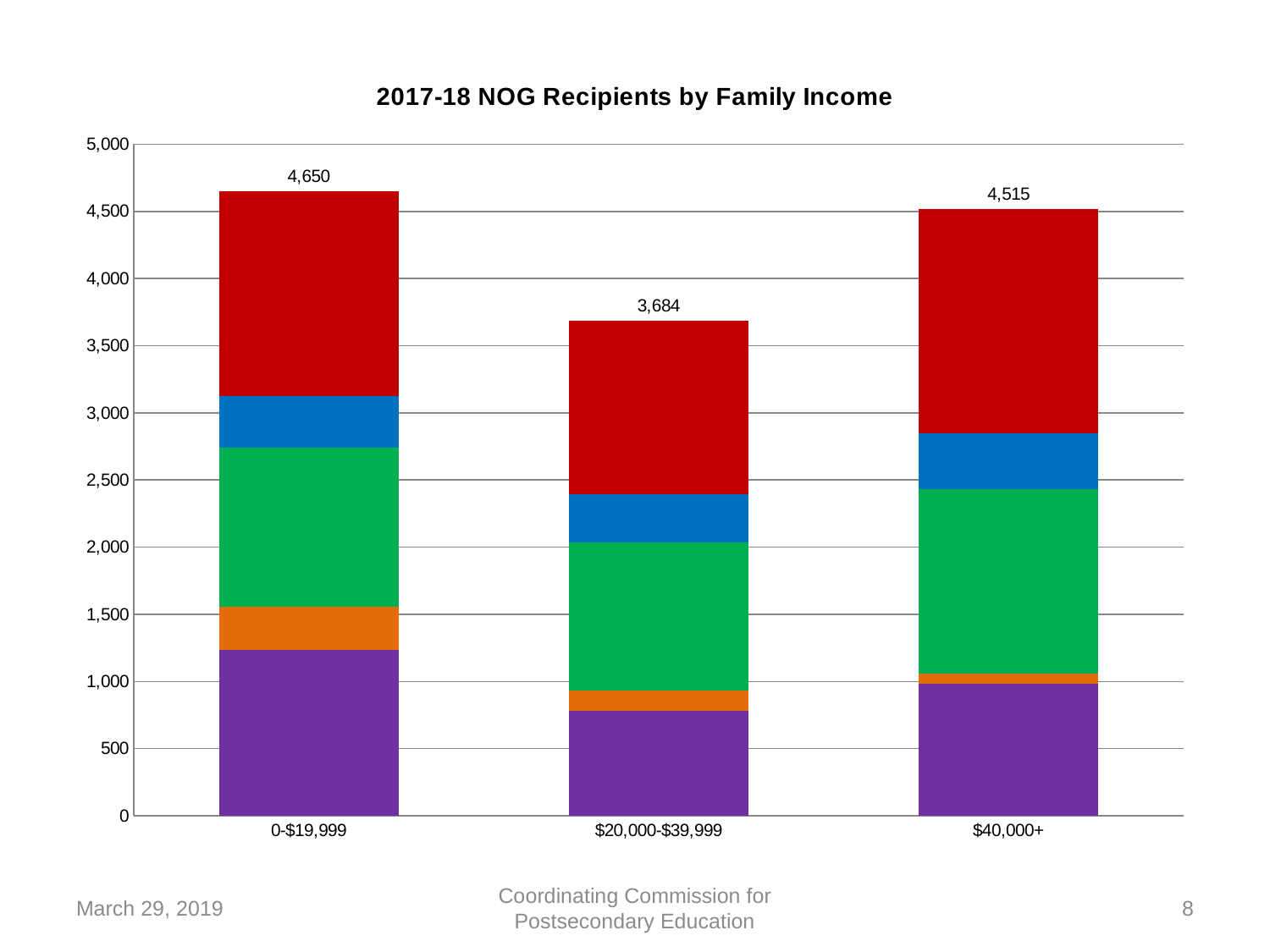
What is the difference between the total for the 0-$19,999 group and the total for the $20,000-$39,999 group? 966 What is the total number of 2017-18 NOG recipients in the 0-$19,999 family income group? 4,650 Which family income group has the highest total number of NOG recipients? 0-$19,999 What is the difference between the total for the $40,000+ group and the total for the $20,000-$39,999 group? 831 Which family income group has the lowest total number of NOG recipients? $20,000-$39,999 What kind of chart is shown on the slide? Stacked bar chart What is the total number of 2017-18 NOG recipients in the $20,000-$39,999 family income group? 3,684 How many family income groups are shown on the x axis? 3 Is the value of the bottom purple segment for the 0-$19,999 group greater or less than 1,000? greater What is the total number of 2017-18 NOG recipients in the $40,000+ family income group? 4,515 Which has a larger total of NOG recipients, the 0-$19,999 group or the $40,000+ group? 0-$19,999 What is the title of the chart? 2017-18 NOG Recipients by Family Income